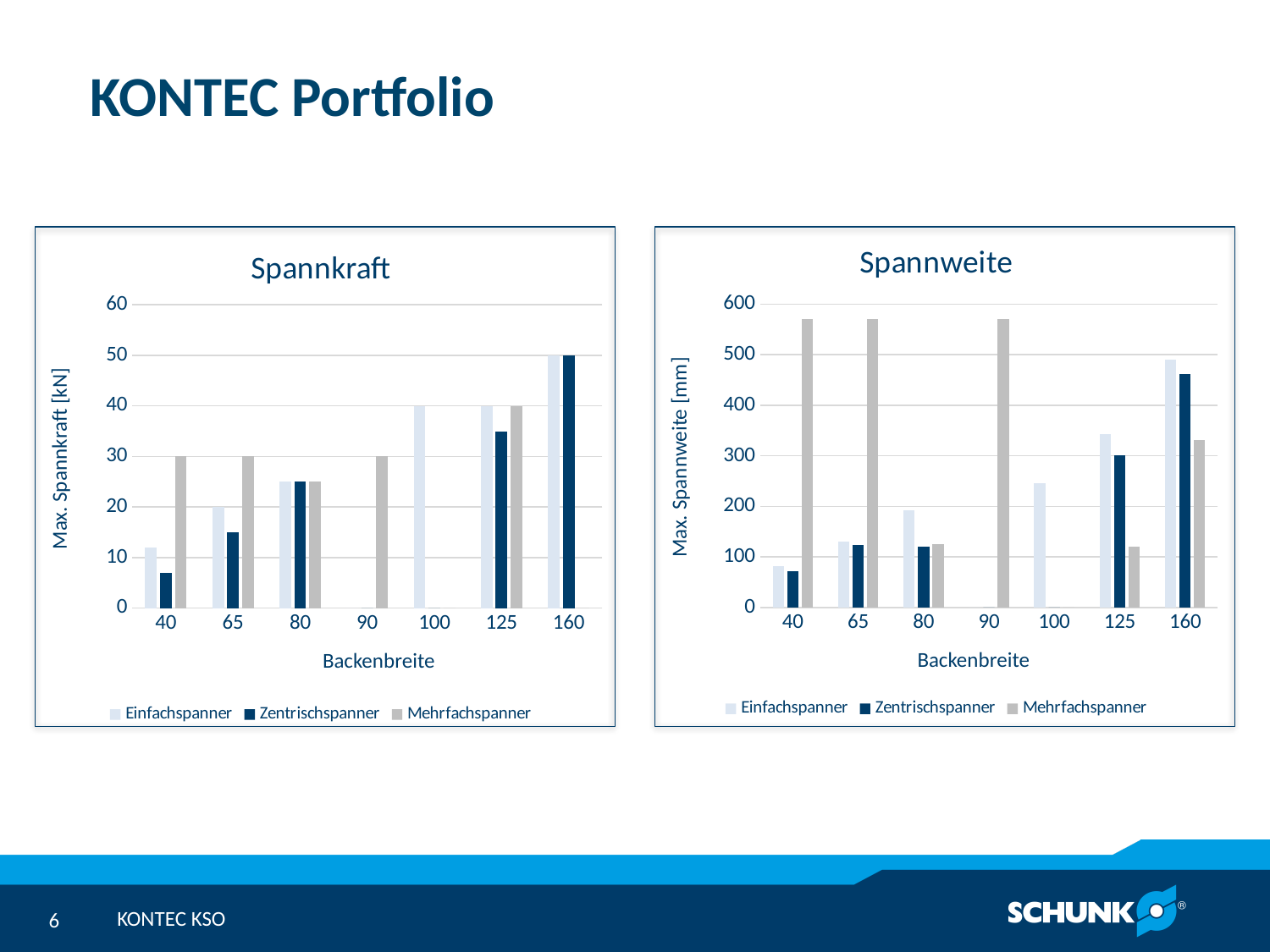
In the Spannweite chart, is the value for Mehrfachspanner at Backenbreite 40 greater or less than 500? greater How many Backenbreite categories are shown on the x axis of the Spannkraft chart? 7 What kind of chart is the Spannkraft chart? bar chart In the Spannweite chart, at which Backenbreite is the Einfachspanner value highest? 160 What is the y-axis title of the Spannweite chart? Max. Spannweite [mm] In the Spannkraft chart, what is the value for Einfachspanner at Backenbreite 160? 50 How many series does the legend of the Spannweite chart list? 3 In the Spannkraft chart, at Backenbreite 40, which is larger: Einfachspanner or Zentrischspanner? Einfachspanner In the Spannkraft chart, what is the value for Mehrfachspanner at Backenbreite 40? 30 In the Spannkraft chart, what is the value for Einfachspanner at Backenbreite 100? 40 In the Spannweite chart, is the value for Einfachspanner at Backenbreite 100 greater or less than 200? greater